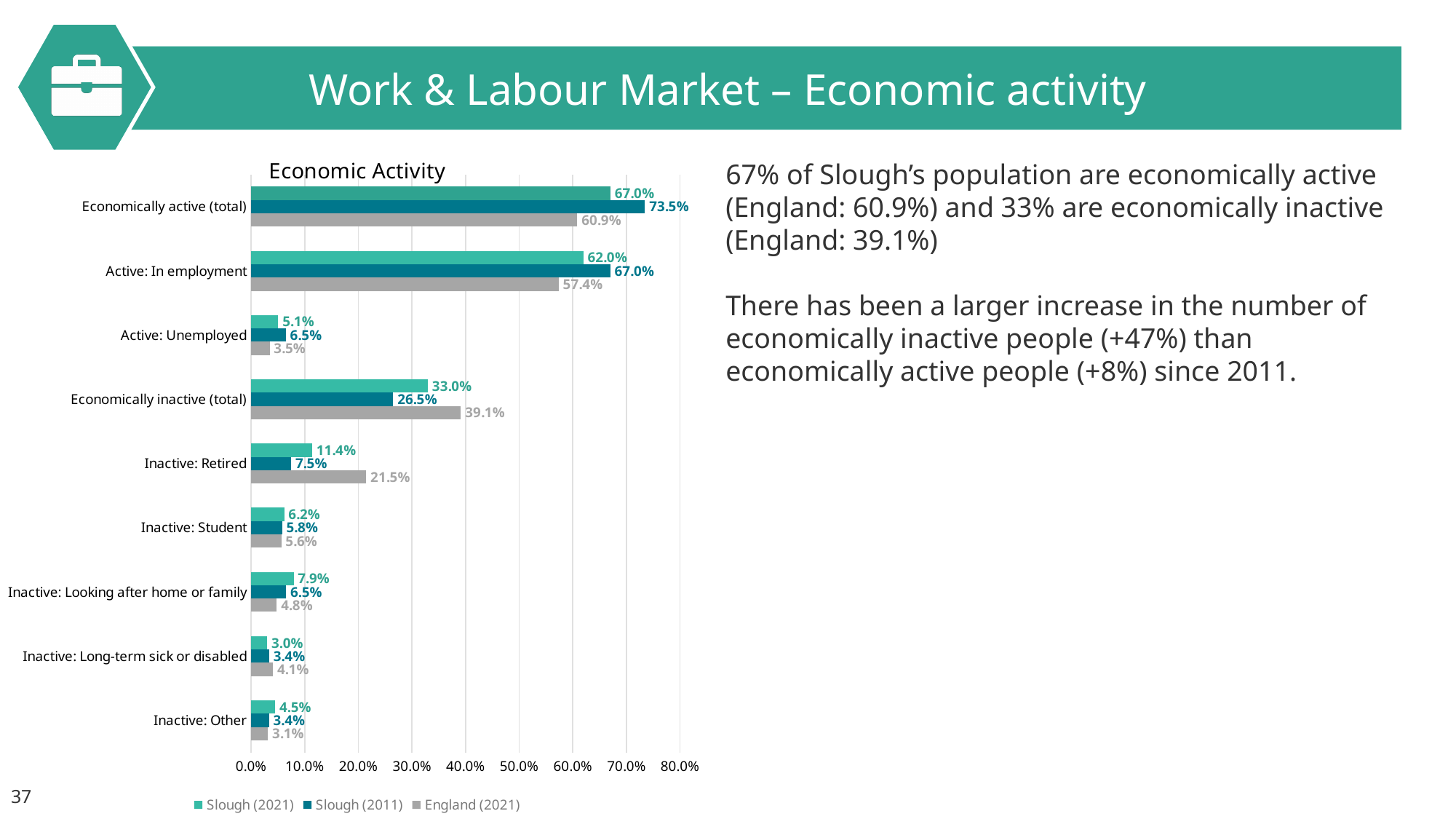
How many series does the legend list? 3 What is the Slough (2021) value for Economically active (total)? 67.0% What is the England (2021) value for Inactive: Retired? 21.5% Which category has the highest Slough (2011) value? Economically active (total) How many categories are shown on the chart? 9 What is the difference between the Slough (2011) and Slough (2021) values for Economically active (total)? 6.5% What is the title of the chart? Economic Activity Which category has the lowest Slough (2021) value? Inactive: Long-term sick or disabled What kind of chart is shown on the slide? Bar chart Is the England (2021) value for Active: In employment greater or less than 50.0%? greater Which is larger for Inactive: Retired, the Slough (2021) value or the England (2021) value? England (2021) What is the Slough (2011) value for Economically inactive (total)? 26.5%